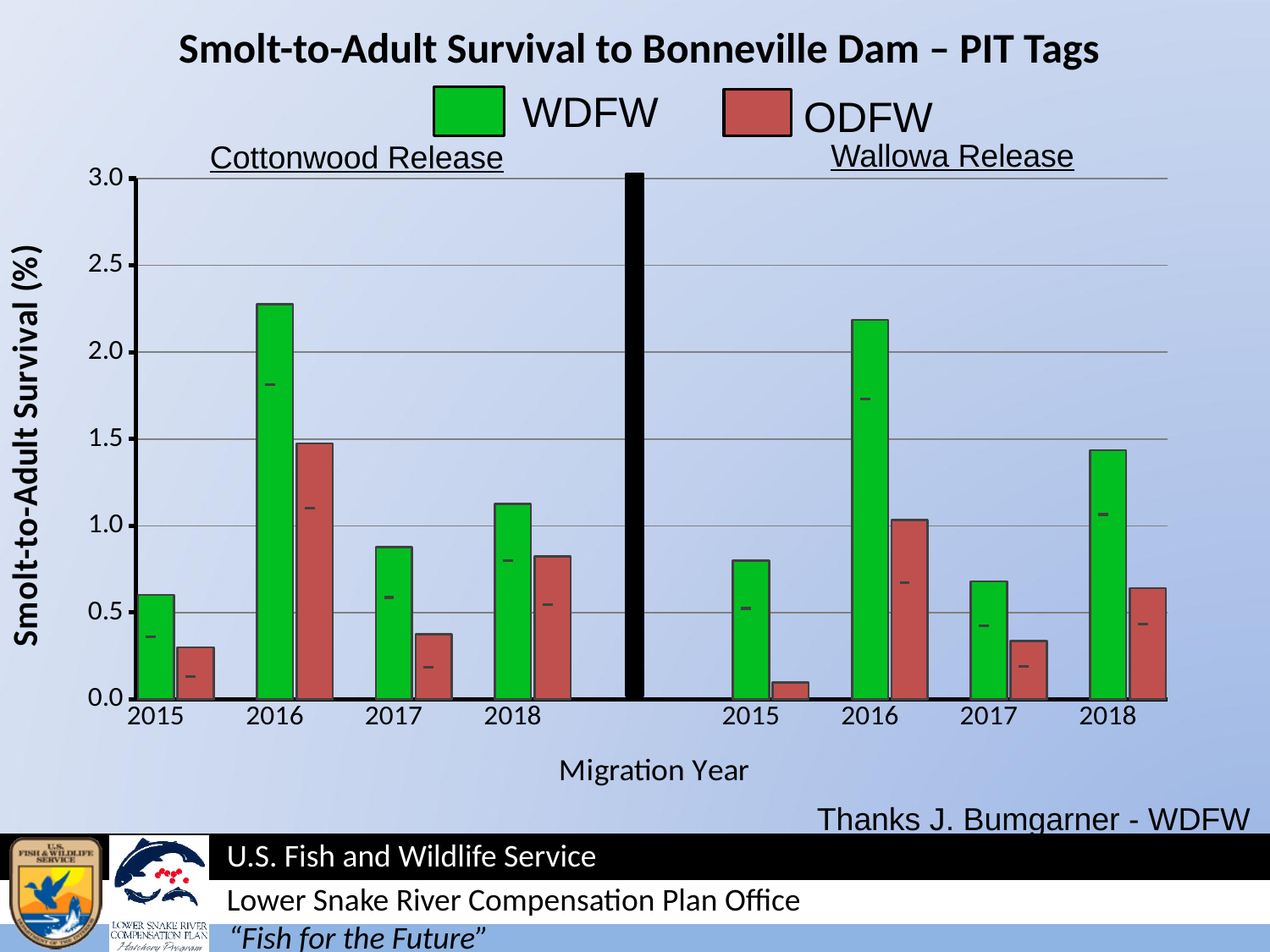
In the Cottonwood Release panel, is the WDFW value for 2016 greater or less than 2.0? greater In the Cottonwood Release panel, is the WDFW value for 2018 greater or less than 1.0? greater How many migration years are shown in the Cottonwood Release panel? 4 In the Wallowa Release panel, which is larger for 2018, WDFW or ODFW? WDFW In the Cottonwood Release panel, does WDFW survival rise or fall from 2016 to 2017? fall What kind of chart is shown on the slide? bar chart How many series does the legend list? 2 In the Cottonwood Release panel, which migration year has the highest WDFW survival? 2016 In the Cottonwood Release panel, which is larger for 2016, WDFW or ODFW? WDFW In the Wallowa Release panel, is the ODFW value for 2015 greater or less than 0.5? less What is the label of the y axis? Smolt-to-Adult Survival (%) In the Wallowa Release panel, which migration year has the lowest ODFW survival? 2015